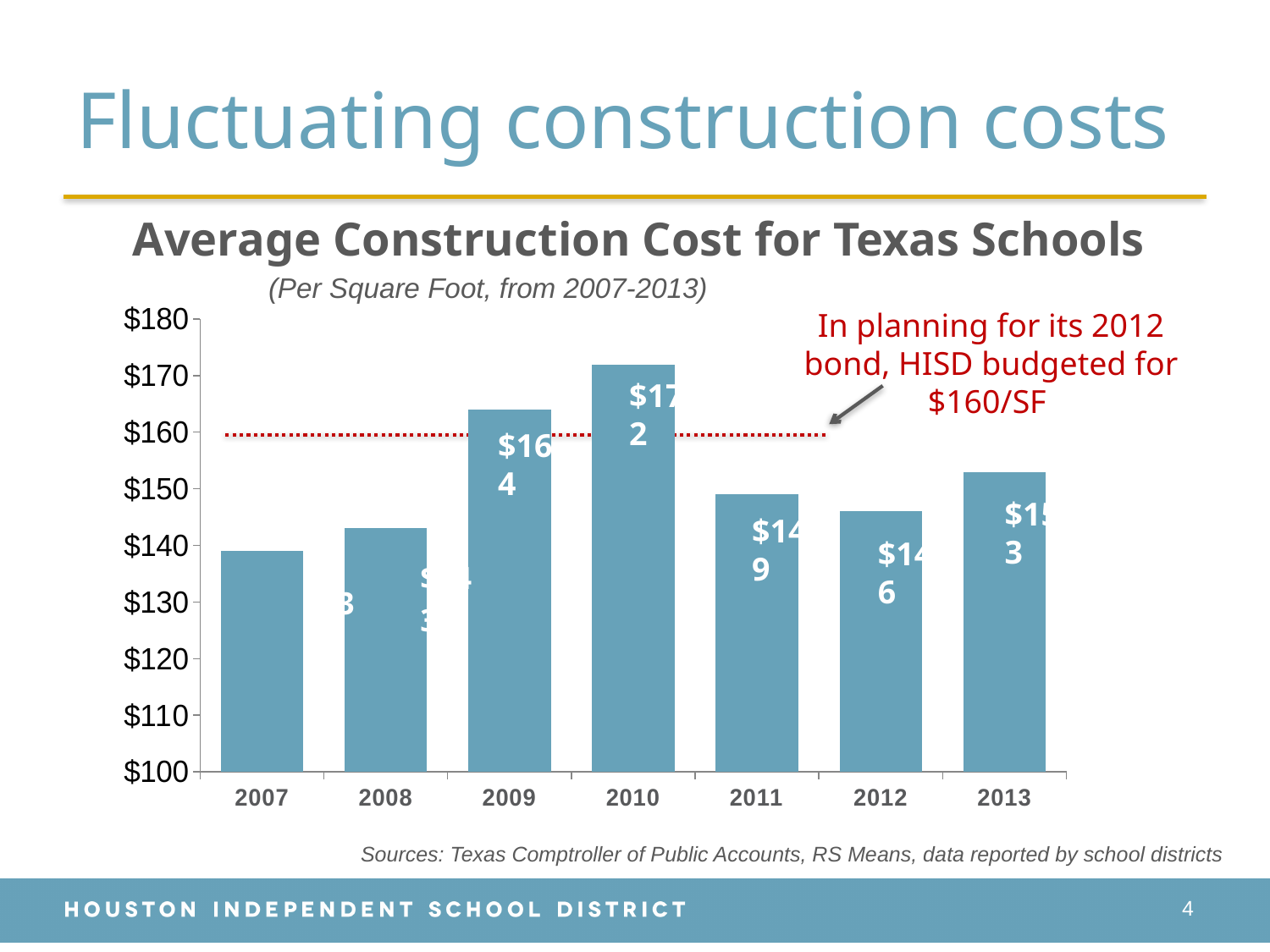
What per-square-foot amount does the dotted horizontal line on the chart represent? $160/SF What is the average construction cost per square foot for 2013? $153 How many years are plotted in the chart? 7 Is the value for 2012 greater or less than $150? less What is the average construction cost per square foot for 2009? $164 Which year has the highest average construction cost per square foot? 2010 Which year has the larger value, 2011 or 2013? 2013 Do the values rise or fall from 2010 to 2012? fall Which year has the lowest average construction cost per square foot? 2007 What kind of chart is shown on the slide? bar chart What is the average construction cost per square foot for 2010? $172